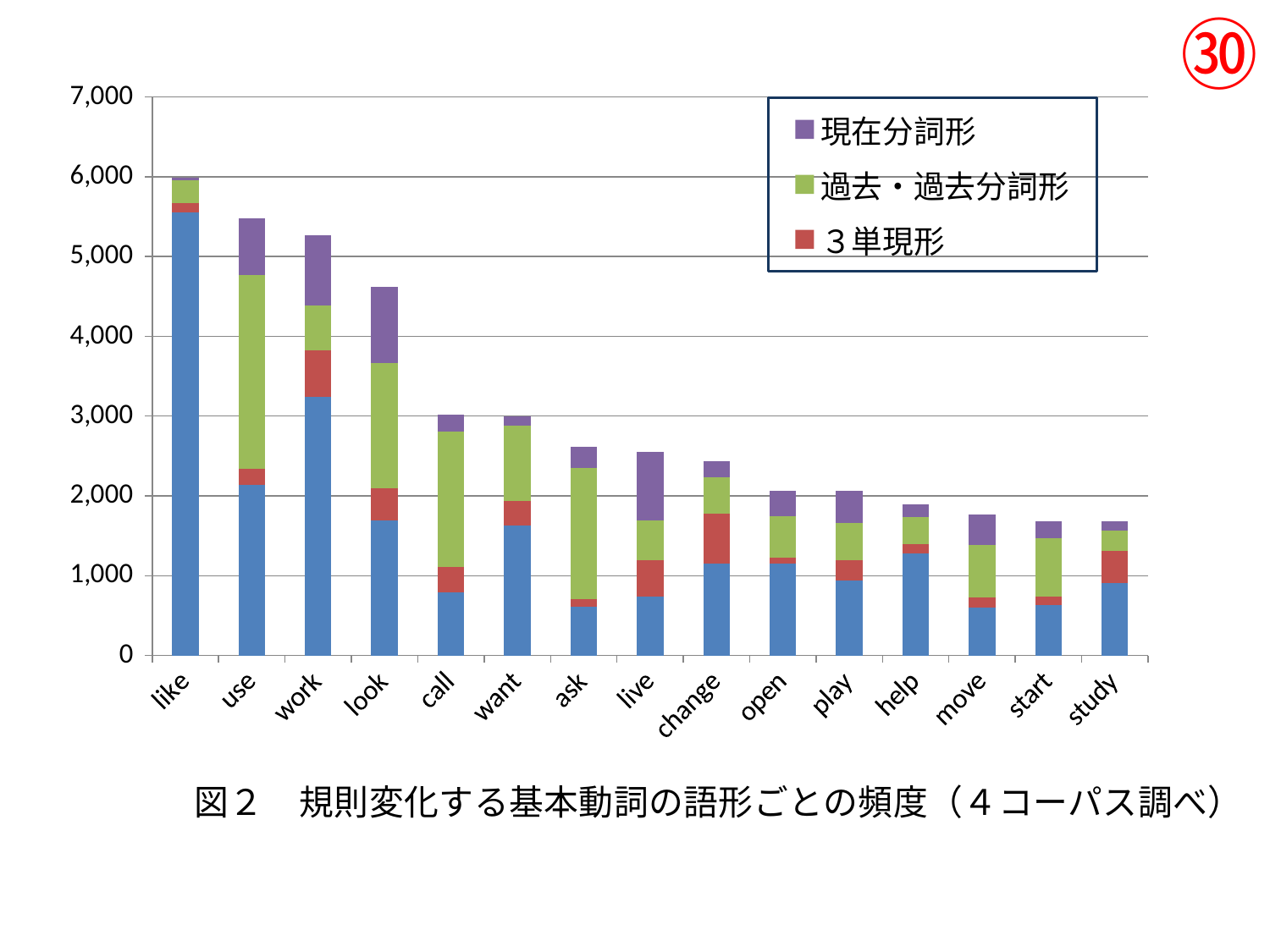
Which has the larger total frequency, 'look' or 'call'? look Which verb has the highest total frequency? like What kind of chart is shown on the slide? Stacked bar chart How many verbs (categories) are shown along the x axis? 15 How many series does the legend list? 3 Which has the larger total frequency, 'like' or 'use'? like Is the total value for 'ask' greater or less than 2,000? greater Do the total bar heights generally rise or fall from left to right along the x axis? fall Which colour represents 現在分詞形 in the legend? Purple Is the total value for 'like' greater or less than 5,000? greater Is the total value for 'look' greater or less than 4,000? greater